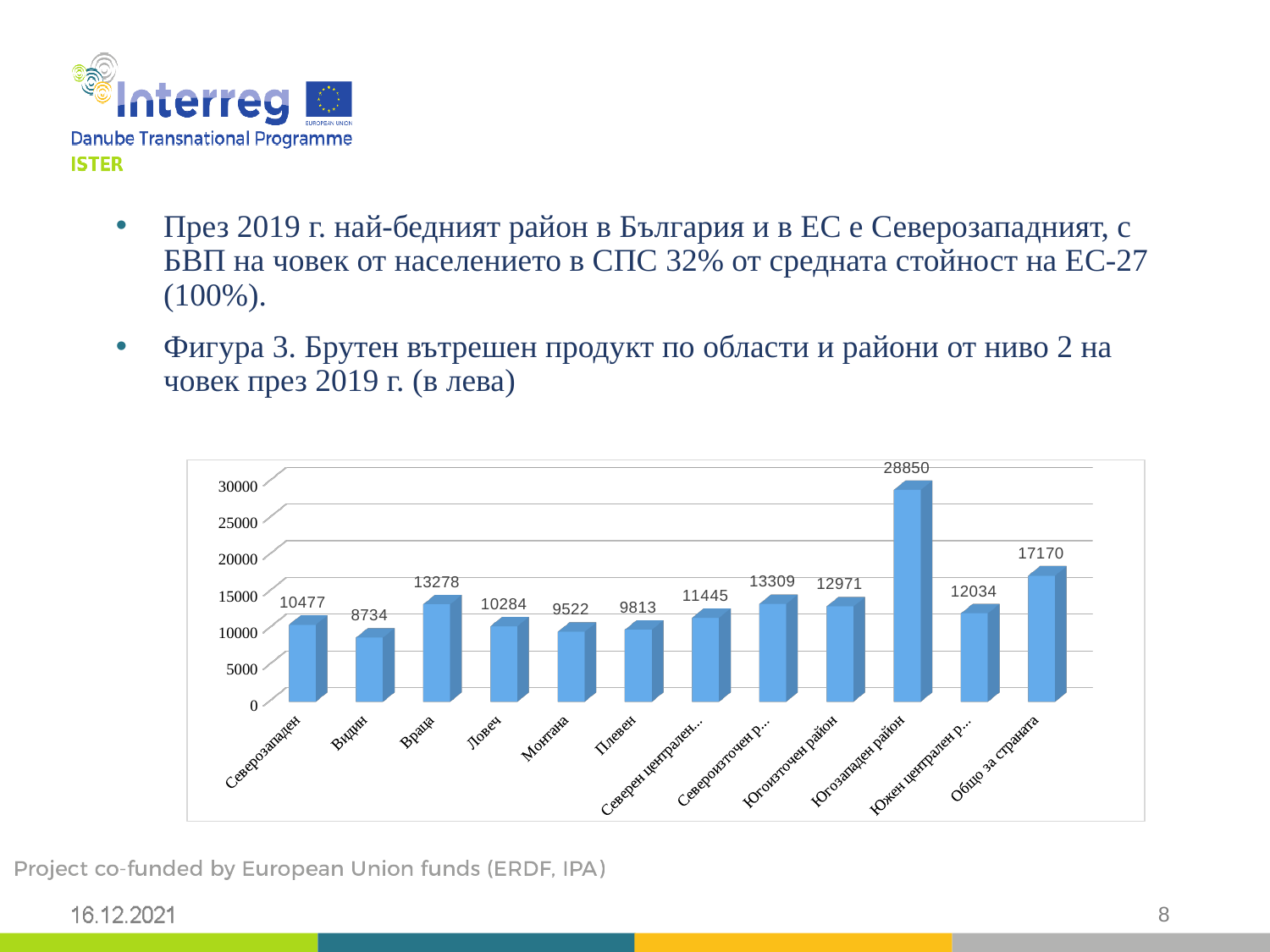
What is the value for Видин? 8734 What is the value for Югозападен район? 28850 Which is larger, the value for Плевен or the value for Северозападен? Северозападен What is the value for Общо за страната? 17170 What is the difference between the values for Враца and Ловеч? 2994 Is the value for Югоизточен район greater or less than 10000? greater What is the difference between the values for Югозападен район and Общо за страната? 11680 Which category has the highest value? Югозападен район What is the value for Монтана? 9522 What kind of chart is shown on the slide? bar chart How many categories are shown on the x axis? 12 Which category has the lowest value? Видин